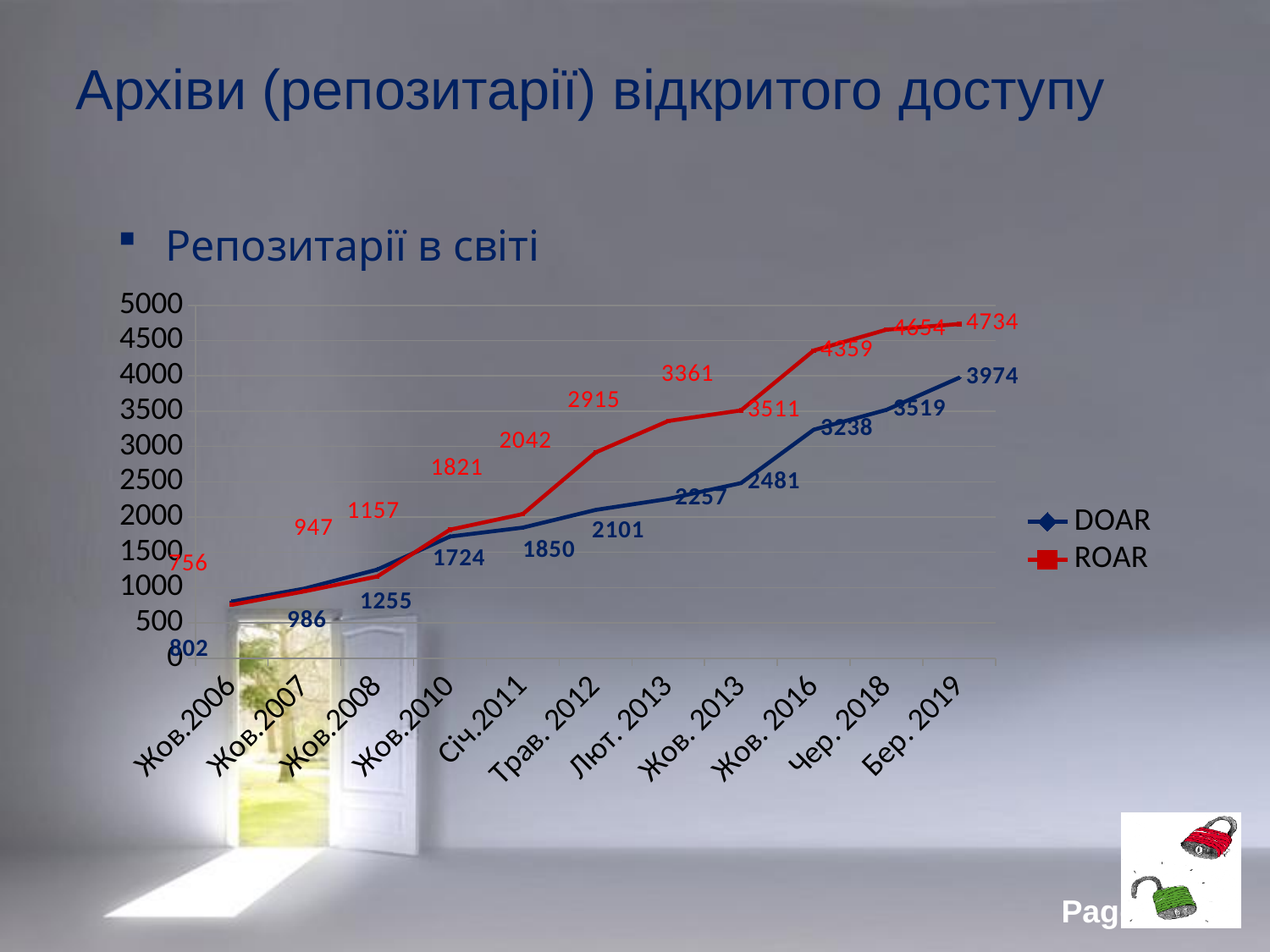
What is the DOAR value for Бер. 2019? 3974 What kind of chart is shown on the slide? line chart What is the DOAR value for Жов.2006? 802 At Жов.2006, which series has the larger value, DOAR or ROAR? DOAR How many series does the legend list? 2 What is the ROAR value for Бер. 2019? 4734 What is the DOAR value for Трав. 2012? 2101 At which time point does the ROAR series reach its highest value? Бер. 2019 Do the values of the ROAR series rise or fall along the x axis? rise What is the ROAR value for Лют. 2013? 3361 What is the difference between the ROAR and DOAR values at Бер. 2019? 760 How many time points are plotted along the x axis? 11